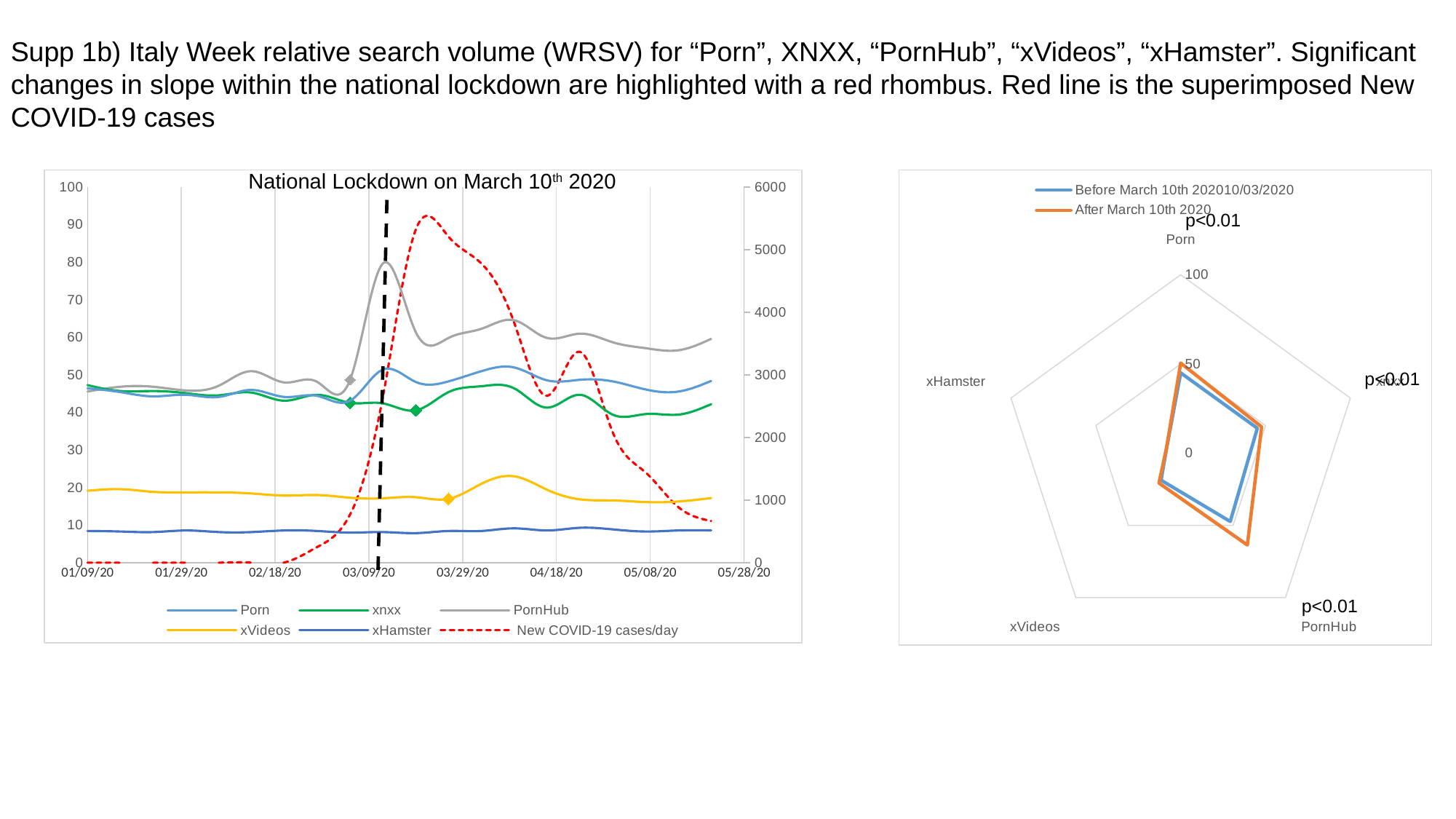
In the left chart, which search-term series reaches the highest value on the left axis? PornHub In the right radar chart, how many series does the legend list? 2 In the left chart, is the value of the xHamster line greater or less than 10 throughout the period? less In the left chart, which series is larger, xVideos or xHamster? xVideos In the right radar chart, how many categories (axes) are there? 5 In the right radar chart, which series has the larger value for PornHub, Before March 10th 2020 or After March 10th 2020? After March 10th 2020 What kind of chart is the left chart titled "National Lockdown on March 10th 2020"? line chart In the left chart, what is the maximum value shown on the right-hand axis? 6000 In the left chart, is the peak value of the PornHub line greater or less than 70? greater What kind of chart is the right chart with the legend "Before March 10th 2020" and "After March 10th 2020"? radar chart In the left chart, which search-term series has the lowest values on the left axis? xHamster In the left chart, how many series does the legend list? 6